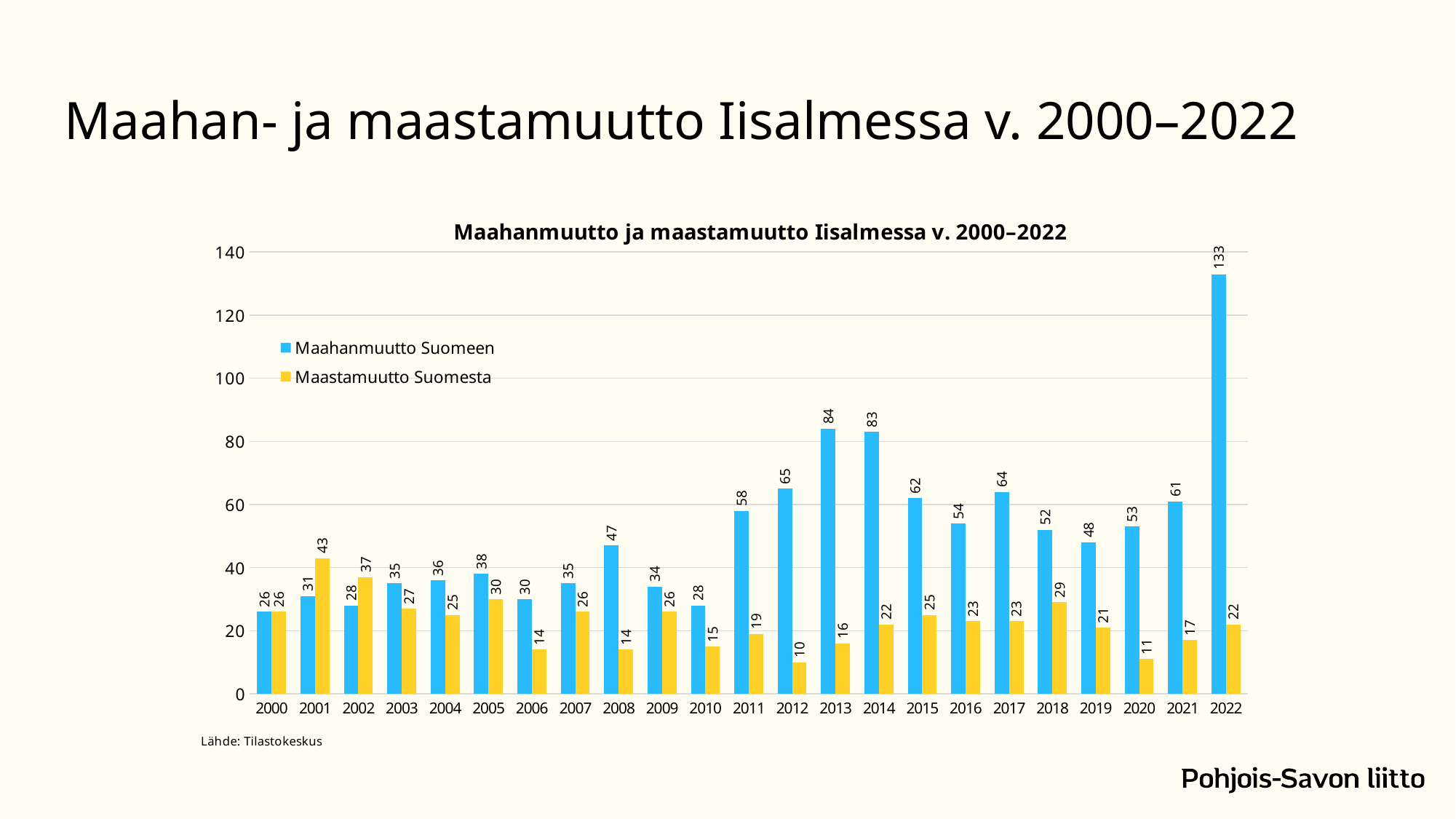
What is the value of Maastamuutto Suomesta in 2012? 10 What is the value of Maahanmuutto Suomeen in 2000? 26 What is the difference between Maahanmuutto Suomeen and Maastamuutto Suomesta in 2013? 68 How many series does the legend list? 2 What is the value of Maahanmuutto Suomeen in 2022? 133 Which year has the lowest value for Maastamuutto Suomesta? 2012 Which year has the highest value for Maahanmuutto Suomeen? 2022 What kind of chart is shown on the slide? Bar chart What colour are the Maastamuutto Suomesta bars? Yellow Is the value for Maahanmuutto Suomeen in 2021 greater or less than 40? greater How many years are shown on the x axis? 23 Which is larger in 2001, Maahanmuutto Suomeen or Maastamuutto Suomesta? Maastamuutto Suomesta